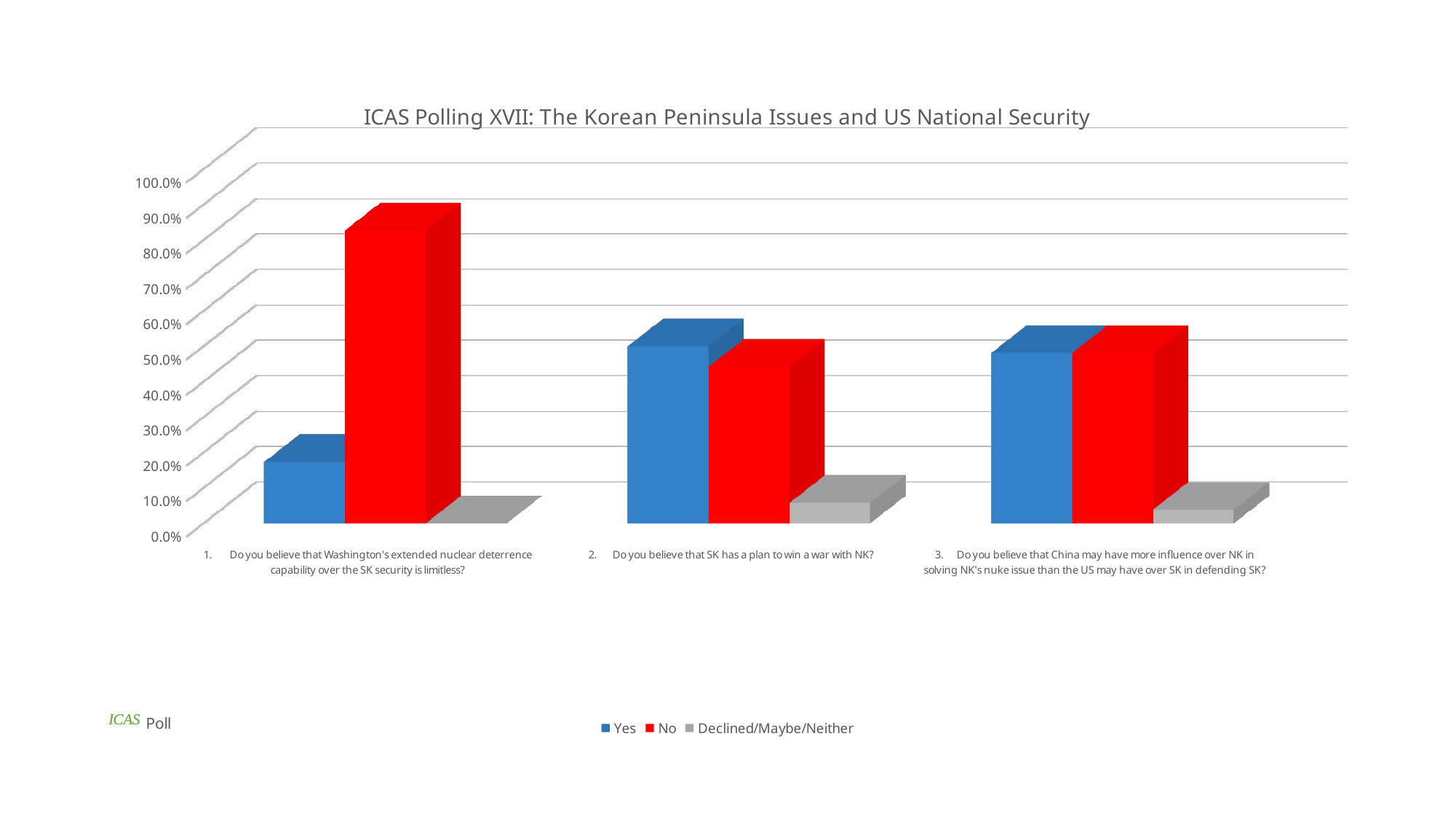
Is the "Yes" value for question 1 (Washington's extended nuclear deterrence capability) greater or less than 30.0%? less Is the "No" value for question 1 (Washington's extended nuclear deterrence capability) greater or less than 70.0%? greater What is the title of the chart? ICAS Polling XVII: The Korean Peninsula Issues and US National Security What kind of chart is shown on the slide? Bar chart Which poll question has the lowest "Yes" value? Question 1 (Washington's extended nuclear deterrence capability over the SK security is limitless?) For question 1, which is larger: the "Yes" value or the "No" value? No How many series does the legend list? 3 Is the "Yes" value for question 2 (SK has a plan to win a war with NK) greater or less than 40.0%? greater How many poll questions (categories) are plotted on the x axis? 3 Which colour represents the "No" series in the legend? Red Which poll question has the highest "No" value? Question 1 (Washington's extended nuclear deterrence capability over the SK security is limitless?)